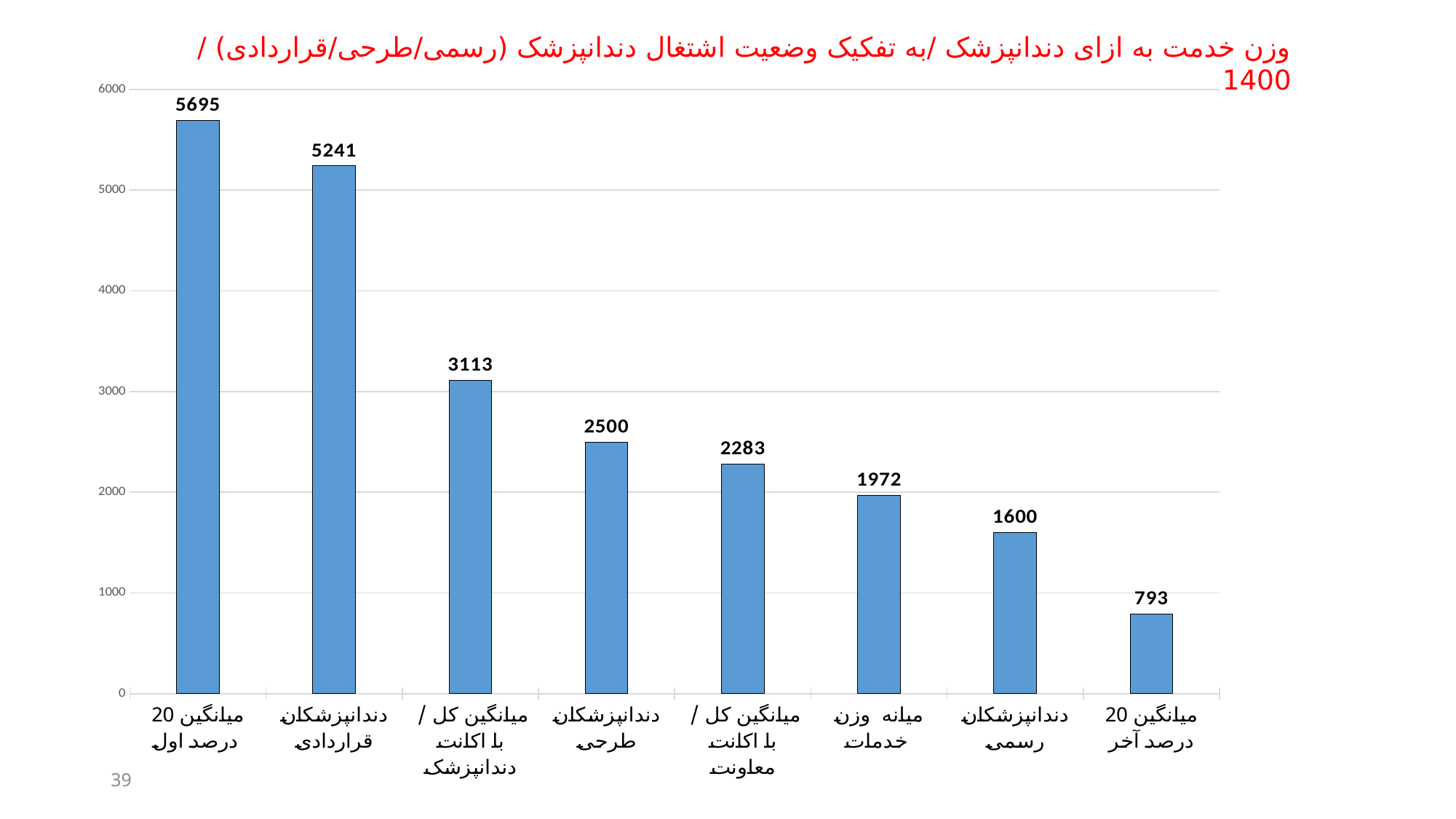
How many categories are shown in the chart? 8 What is the value for دندانپزشکان قراردادی? 5241 Which category has the lowest value? میانگین 20 درصد آخر What is the difference between the values for دندانپزشکان قراردادی and دندانپزشکان رسمی? 3641 Which is larger, the value for دندانپزشکان طرحی or the value for میانگین کل / با اکانت معاونت? دندانپزشکان طرحی What kind of chart is shown on the slide? bar chart Which category has the highest value? میانگین 20 درصد اول What is the difference between the values for میانگین 20 درصد اول and میانگین 20 درصد آخر? 4902 What is the value for دندانپزشکان رسمی? 1600 Do the values rise or fall from left to right across the categories? fall What is the value for دندانپزشکان طرحی? 2500 What is the value for میانه وزن خدمات? 1972